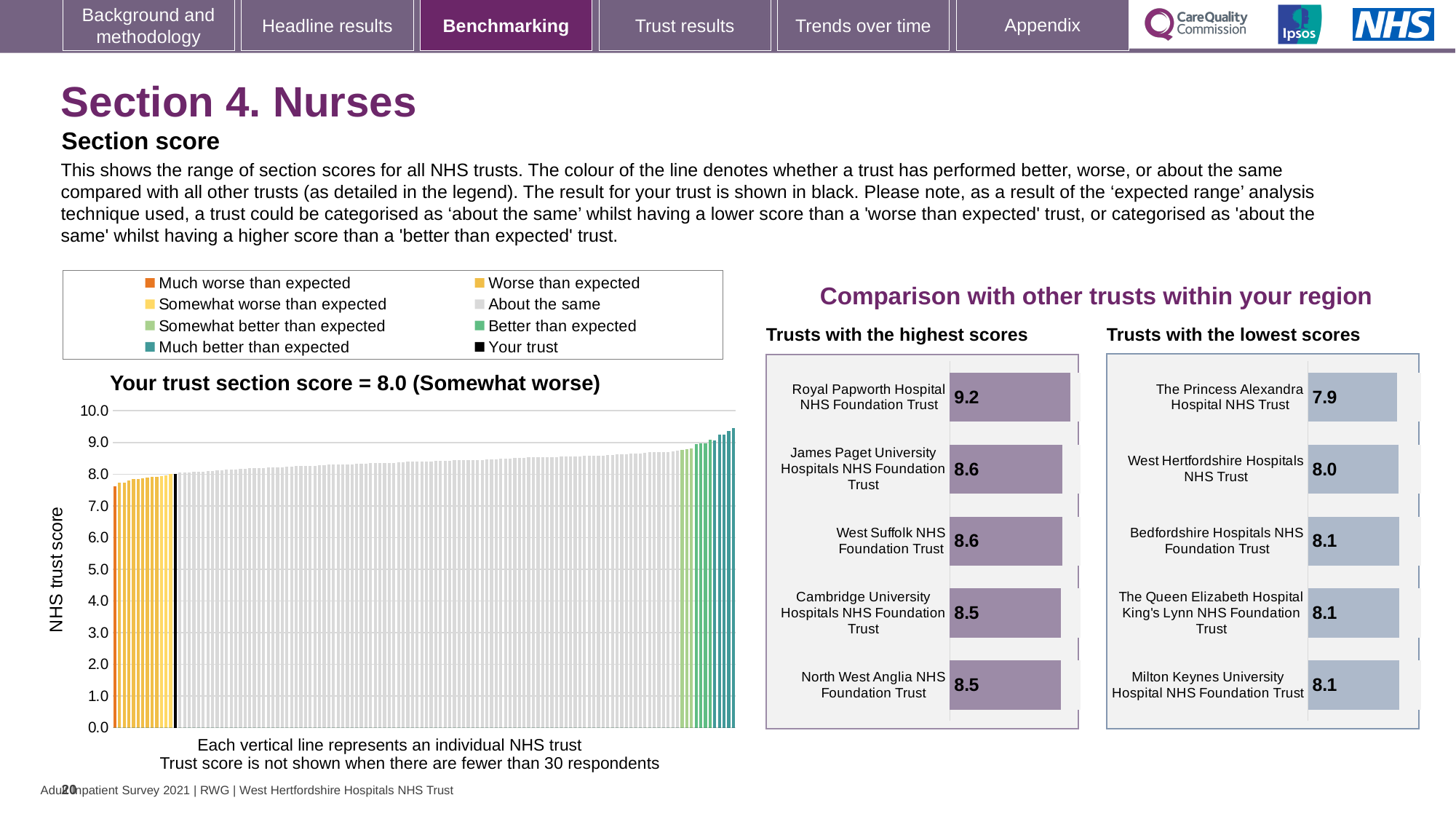
How many trusts are listed in the 'Trusts with the lowest scores' chart? 5 In the main section score chart on the left, is the value of the lowest (leftmost) bar greater or less than 8.0? less In the 'Trusts with the highest scores' chart, which has the larger score: Royal Papworth Hospital NHS Foundation Trust or Cambridge University Hospitals NHS Foundation Trust? Royal Papworth Hospital NHS Foundation Trust In the 'Trusts with the highest scores' chart, what is the difference between the scores of Royal Papworth Hospital NHS Foundation Trust and James Paget University Hospitals NHS Foundation Trust? 0.6 What is the difference between Royal Papworth Hospital NHS Foundation Trust's score in the 'Trusts with the highest scores' chart and The Princess Alexandra Hospital NHS Trust's score in the 'Trusts with the lowest scores' chart? 1.3 In the 'Trusts with the highest scores' chart, what is the score for Royal Papworth Hospital NHS Foundation Trust? 9.2 In the 'Trusts with the highest scores' chart, which trust has the highest score? Royal Papworth Hospital NHS Foundation Trust In the 'Trusts with the lowest scores' chart, what is the score for West Hertfordshire Hospitals NHS Trust? 8.0 What kind of chart is the main section score chart on the left of the slide? bar chart In the 'Trusts with the lowest scores' chart, which trust has the lowest score? The Princess Alexandra Hospital NHS Trust In the main section score chart on the left, what is the section score for your trust, as stated in the chart title? 8.0 In the 'Trusts with the lowest scores' chart, what is the score for The Princess Alexandra Hospital NHS Trust? 7.9